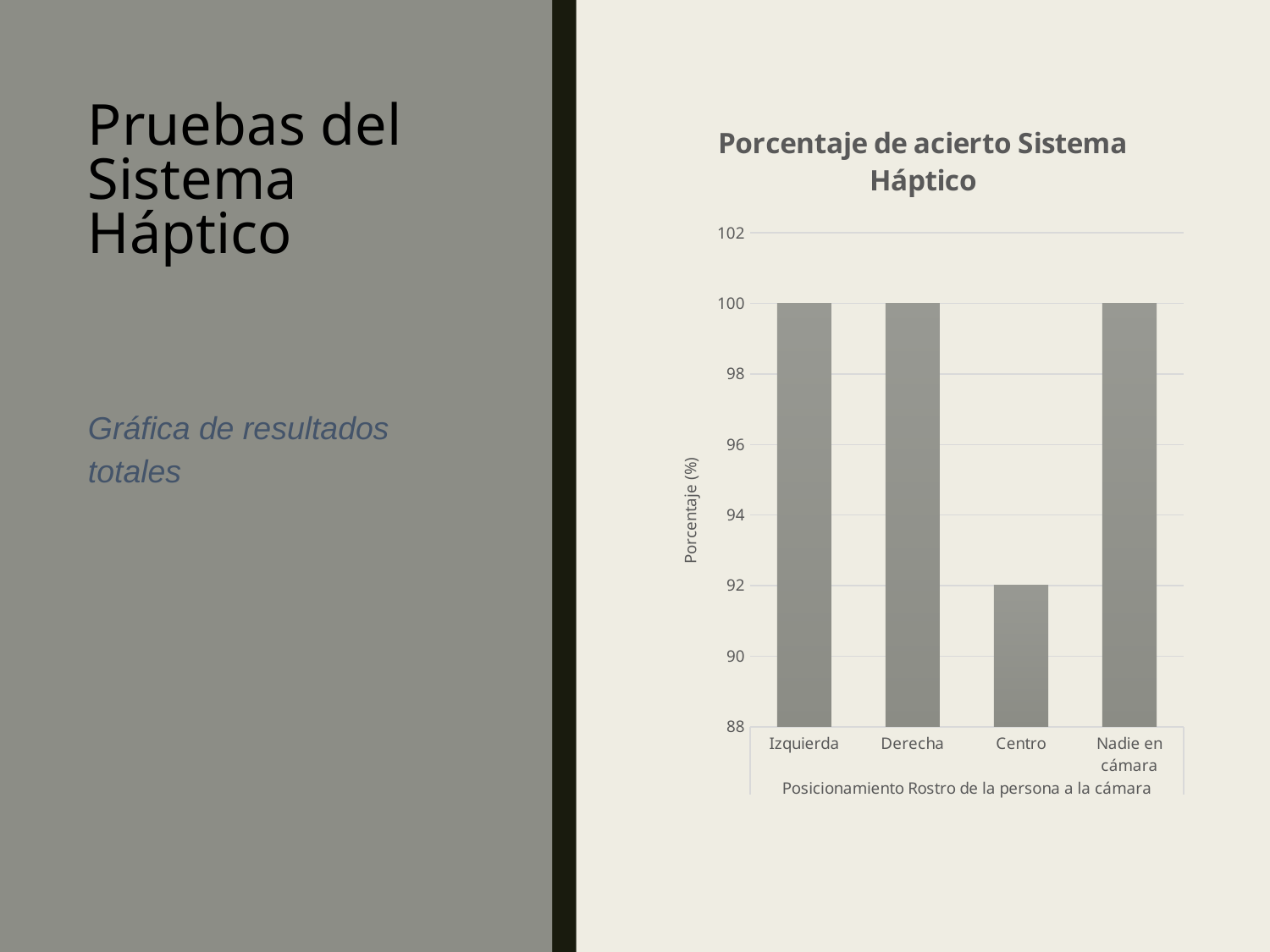
How many categories are shown on the x axis of the chart? 4 What type of chart is shown on the slide? bar chart What is the value for Nadie en cámara? 100 What is the value for Izquierda? 100 Is the value for Izquierda greater or less than 98? greater What is the title of the chart? Porcentaje de acierto Sistema Háptico What is the label of the y axis? Porcentaje (%) What is the difference between the values for Derecha and Centro? 8 Which category has the lowest value? Centro Which is larger, the value for Derecha or the value for Centro? Derecha Is the value for Centro greater or less than 94? less What is the value for Centro? 92